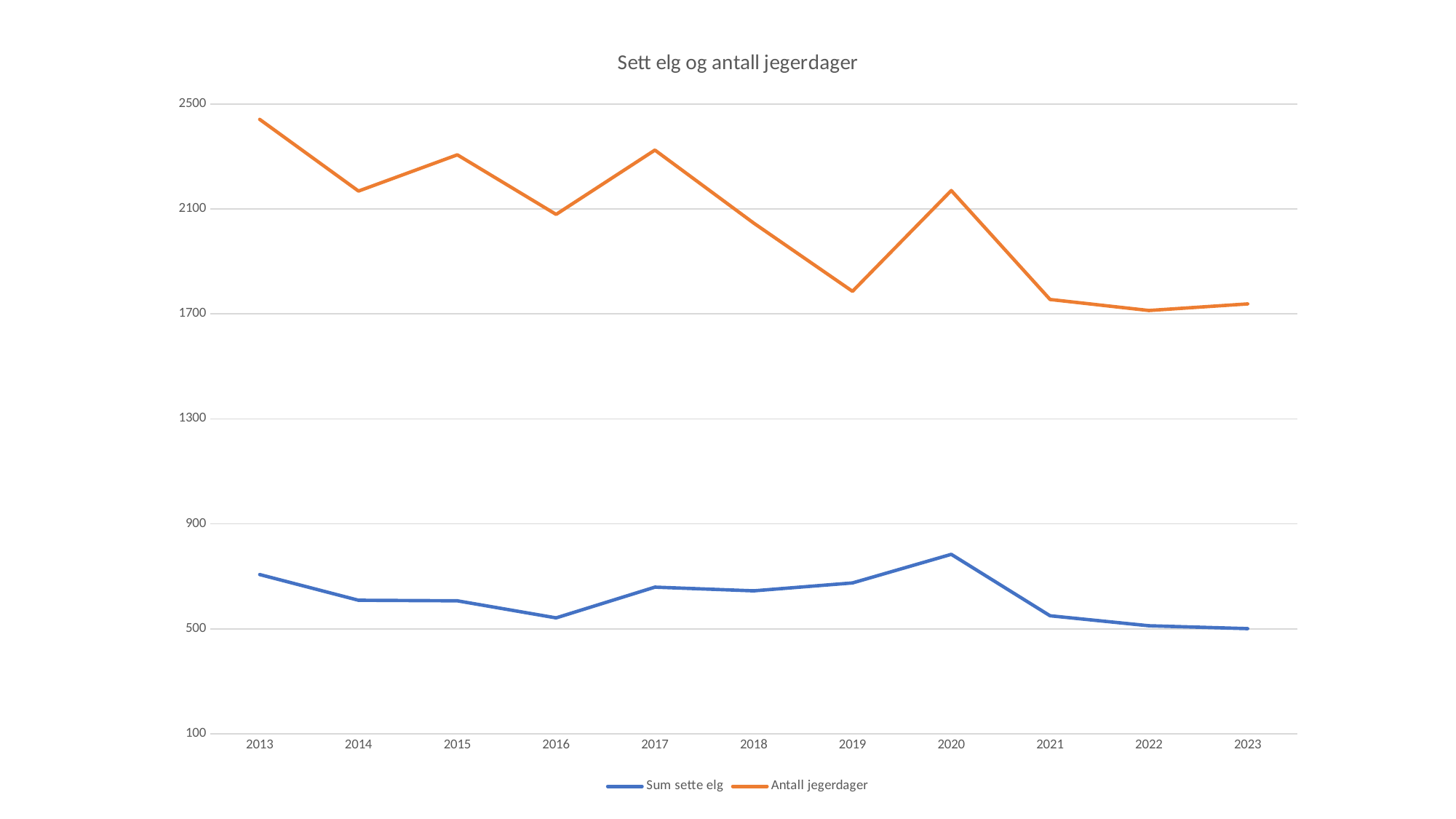
Is the value for Antall jegerdager in 2019 greater or less than 1700? greater Which series is drawn in orange? Antall jegerdager Overall, does Antall jegerdager rise or fall from 2013 to 2023? fall In which year is Antall jegerdager highest? 2013 What is the title of the chart? Sett elg og antall jegerdager How many series does the legend list? 2 Is the value for Sum sette elg in 2020 greater or less than 900? less Which is larger, Antall jegerdager in 2015 or in 2016? 2015 Is the value for Antall jegerdager in 2013 greater or less than 2100? greater What kind of chart is shown on the slide? Line chart In which year is Sum sette elg highest? 2020 How many years are plotted along the x axis? 11